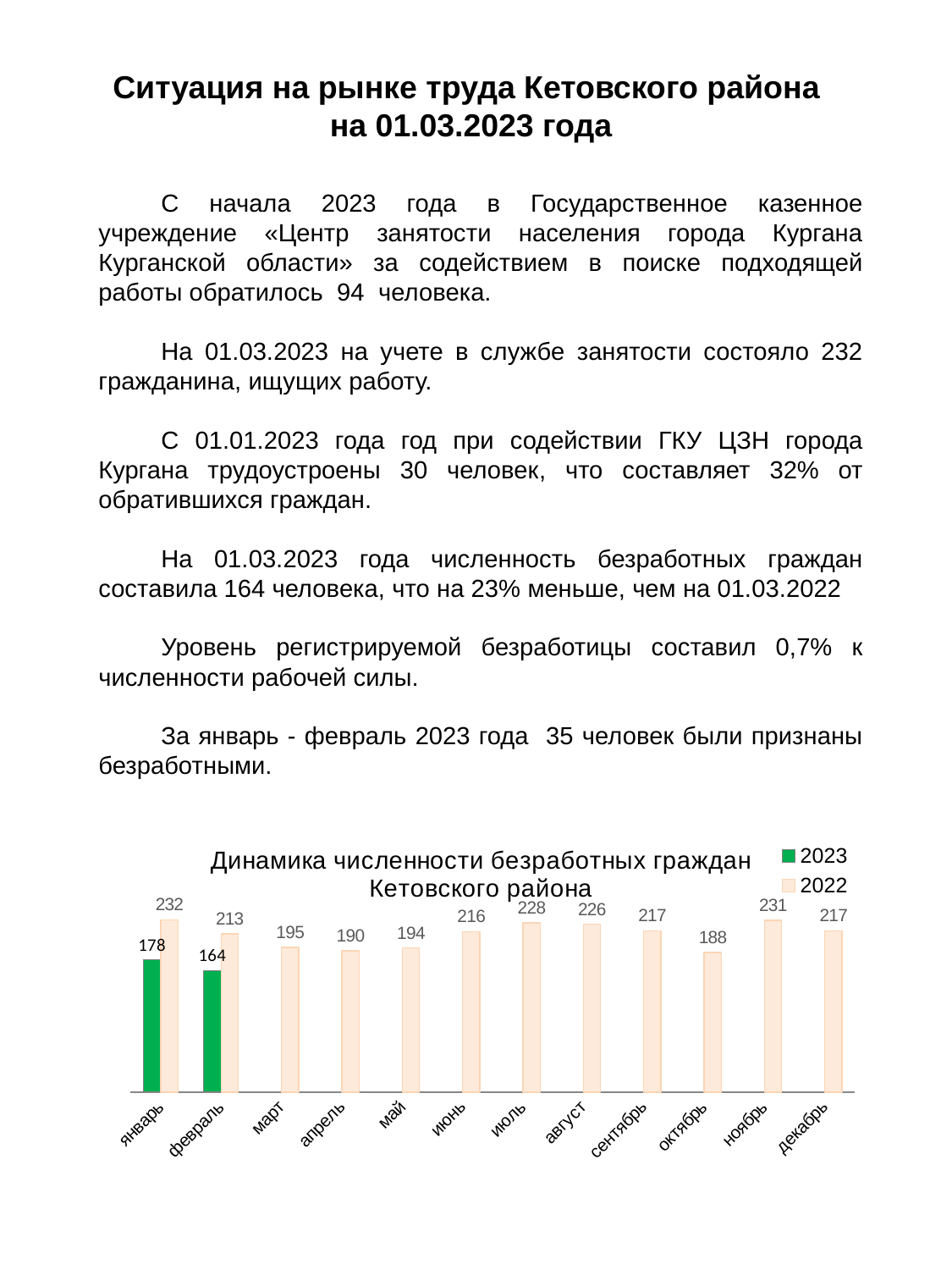
Which month has the highest value for the 2022 series? январь What kind of chart is shown on the slide? bar chart How many months are shown on the x axis? 12 What is the value for 2022 in январь? 232 What is the title of the chart? Динамика численности безработных граждан Кетовского района What is the difference between the 2022 and 2023 values in январь? 54 What is the difference between the 2023 values for январь and февраль? 14 How many series does the legend list? 2 What is the value for 2023 in февраль? 164 Which is larger for 2022: июль or август? июль What is the value for 2022 in октябрь? 188 Which month has the lowest value for the 2022 series? октябрь